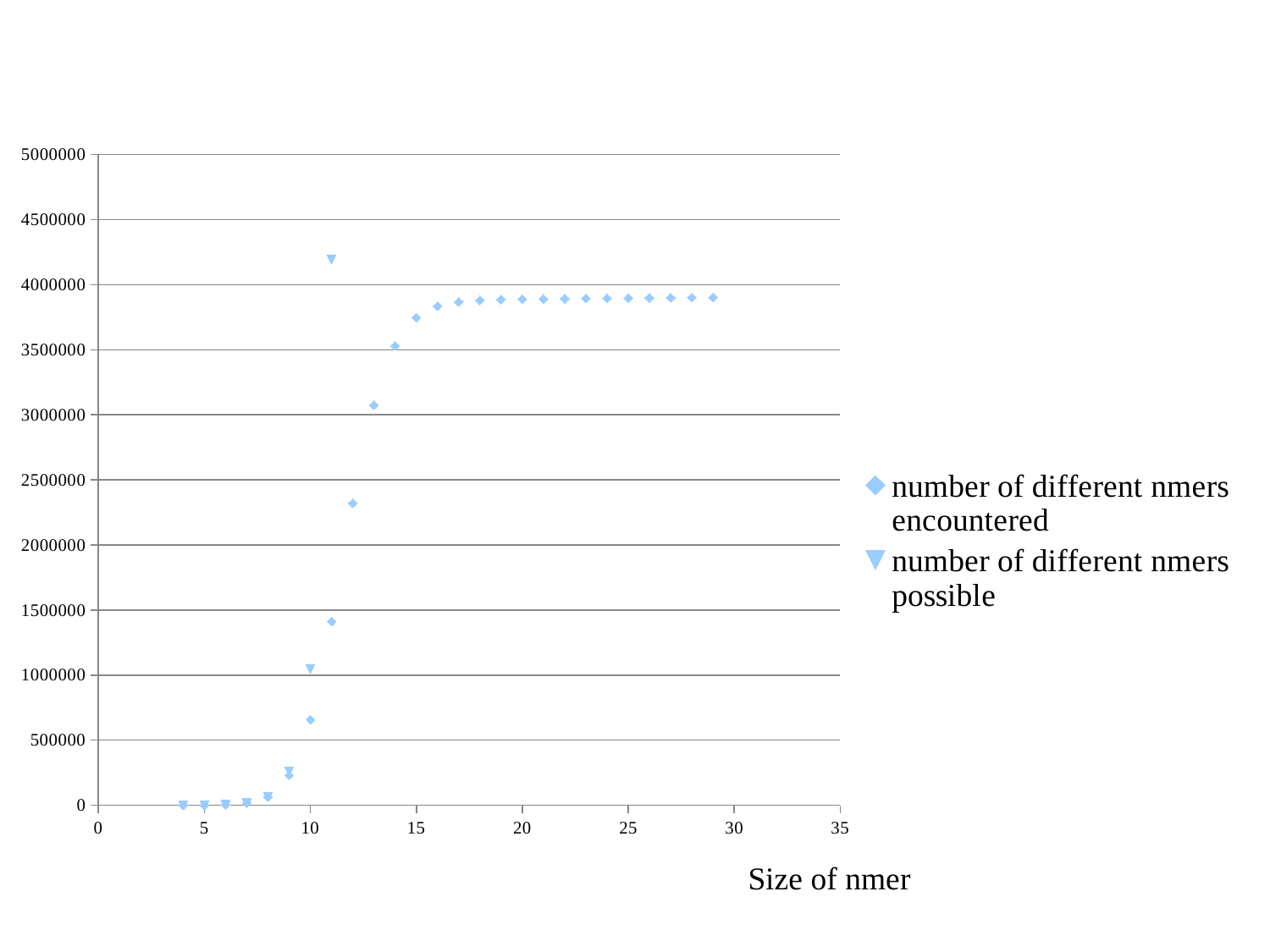
What is the title of the x axis? Size of nmer Is the value for 'number of different nmers encountered' at size of nmer 20 greater or less than 4000000? less Is the value for 'number of different nmers possible' at size of nmer 11 greater or less than 4000000? greater Is the value for 'number of different nmers encountered' at size of nmer 12 greater or less than 2500000? less How many series does the legend list? 2 What are the two series named in the legend? number of different nmers encountered; number of different nmers possible How does the 'number of different nmers encountered' series change as the size of nmer increases from 10 to 29? It rises steeply and then levels off At size of nmer 11, which series has the larger value: 'number of different nmers encountered' or 'number of different nmers possible'? number of different nmers possible What kind of chart is shown on the slide? scatter chart